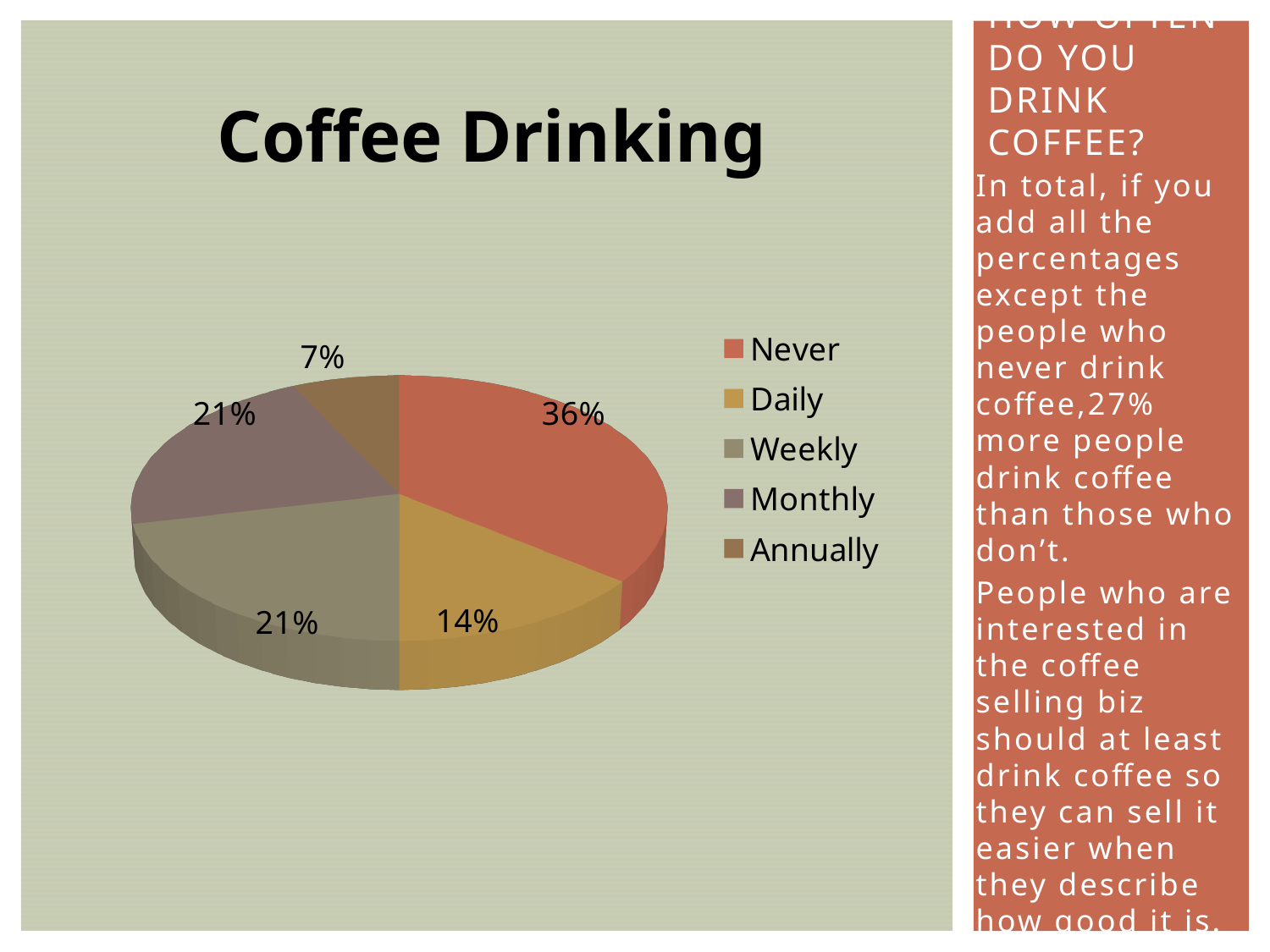
What is the title of the chart? Coffee Drinking Which category has the smallest slice of the pie chart? Annually What type of chart is shown on the slide? Pie chart What percentage of the pie chart is labelled Daily? 14% Which slice is larger, Daily or Monthly? Monthly How many slices does the pie chart have? 5 What percentage of the pie chart is labelled Never? 36% What is the difference in percentage points between the Never slice and the Daily slice? 22 What percentage of the pie chart is labelled Annually? 7% How many entries does the legend list? 5 Which category has the largest slice of the pie chart? Never What percentage of the pie chart is labelled Weekly? 21%